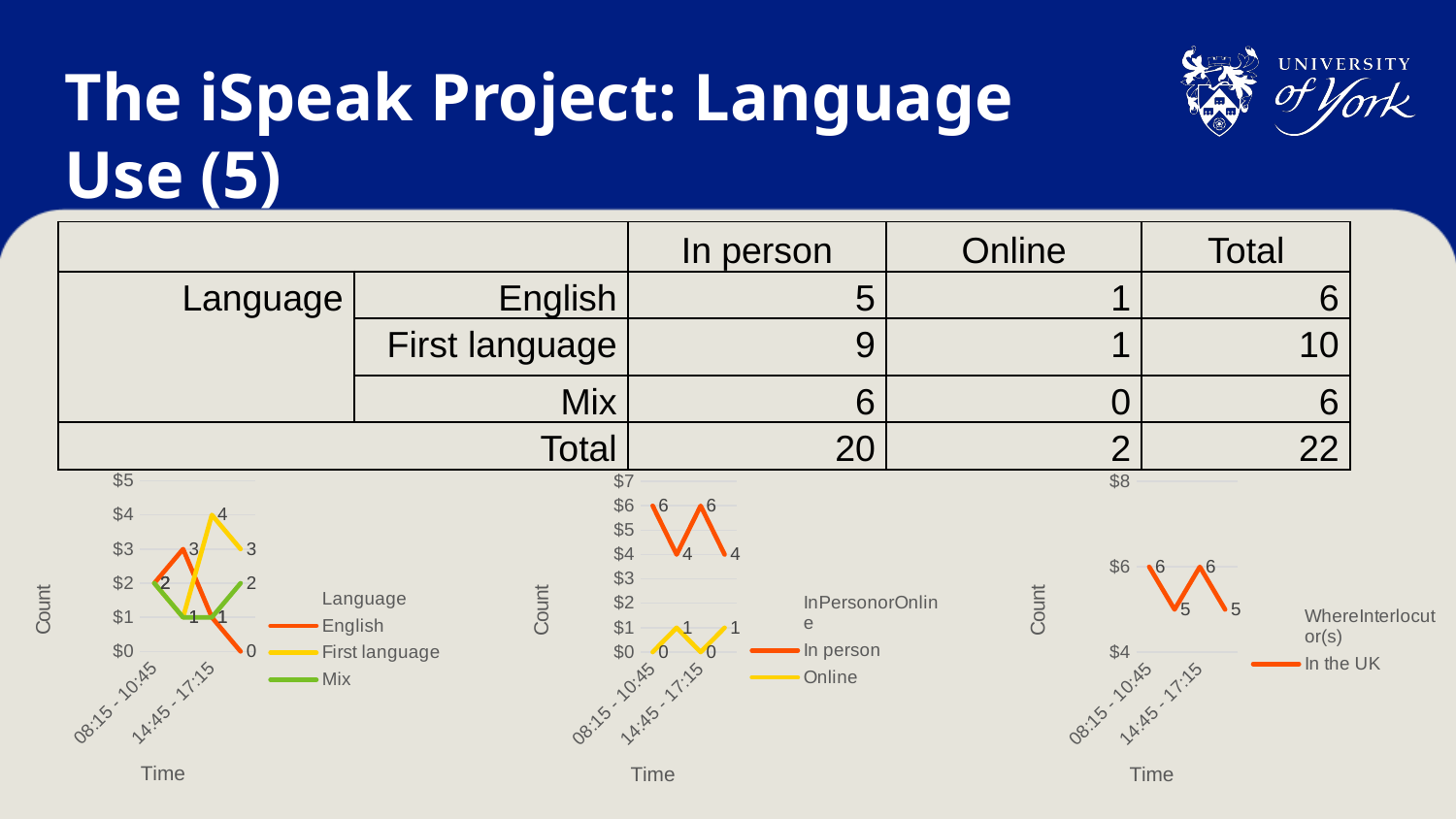
In the middle 'InPersonorOnline' chart, which series has the higher values throughout, 'In person' or 'Online'? In person In the left-hand 'Language' chart, what is the highest value labelled on the 'First language' line? 4 What kind of chart is the left-hand chart with the 'Language' legend? line chart How many series does the legend of the left-hand 'Language' chart list? 3 In the middle 'InPersonorOnline' chart, what is the lowest value labelled on the 'Online' line? 0 What is the x-axis title shared by the three charts at the bottom of the slide? Time In the middle 'InPersonorOnline' chart, what is the highest value labelled on the 'In person' line? 6 How many series does the legend of the middle 'InPersonorOnline' chart list? 2 In the right-hand 'WhereInterlocutor(s)' chart, what is the highest value labelled on the 'In the UK' line? 6 In the right-hand 'WhereInterlocutor(s)' chart, are the values for 'In the UK' greater or less than $4? greater How many series does the legend of the right-hand 'WhereInterlocutor(s)' chart list? 1 In the right-hand 'WhereInterlocutor(s)' chart, what is the lowest value labelled on the 'In the UK' line? 5